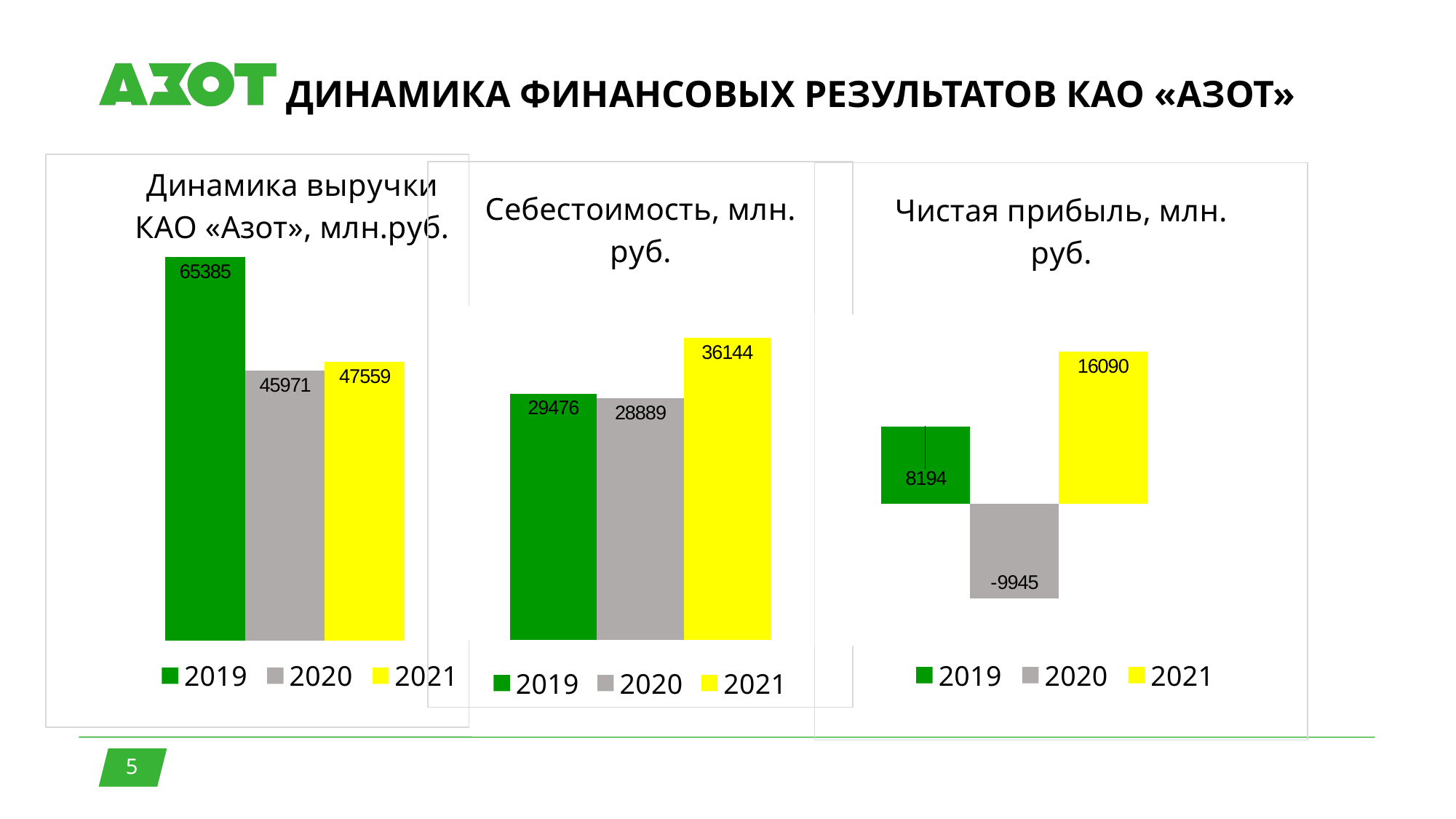
In the chart titled «Динамика выручки КАО «Азот», млн.руб.», what is the difference between the 2019 and 2020 values? 19414 In the chart titled «Чистая прибыль, млн. руб.», what is the value for 2020? -9945 In the chart titled «Динамика выручки КАО «Азот», млн.руб.», which year has the lowest value? 2020 In the chart titled «Динамика выручки КАО «Азот», млн.руб.», what is the value for 2019? 65385 In the chart titled «Чистая прибыль, млн. руб.», what is the difference between the 2021 and 2019 values? 7896 In the chart titled «Себестоимость, млн. руб.», which year has the highest value? 2021 What kind of chart is the chart titled «Динамика выручки КАО «Азот», млн.руб.»? bar chart How many series does the legend of the chart titled «Себестоимость, млн. руб.» list? 3 In the chart titled «Себестоимость, млн. руб.», what is the difference between the 2021 and 2020 values? 7255 In the chart titled «Чистая прибыль, млн. руб.», which is larger, the value for 2019 or the value for 2020? 2019 In the chart titled «Чистая прибыль, млн. руб.», which year has the highest value? 2021 In the chart titled «Себестоимость, млн. руб.», what is the value for 2021? 36144